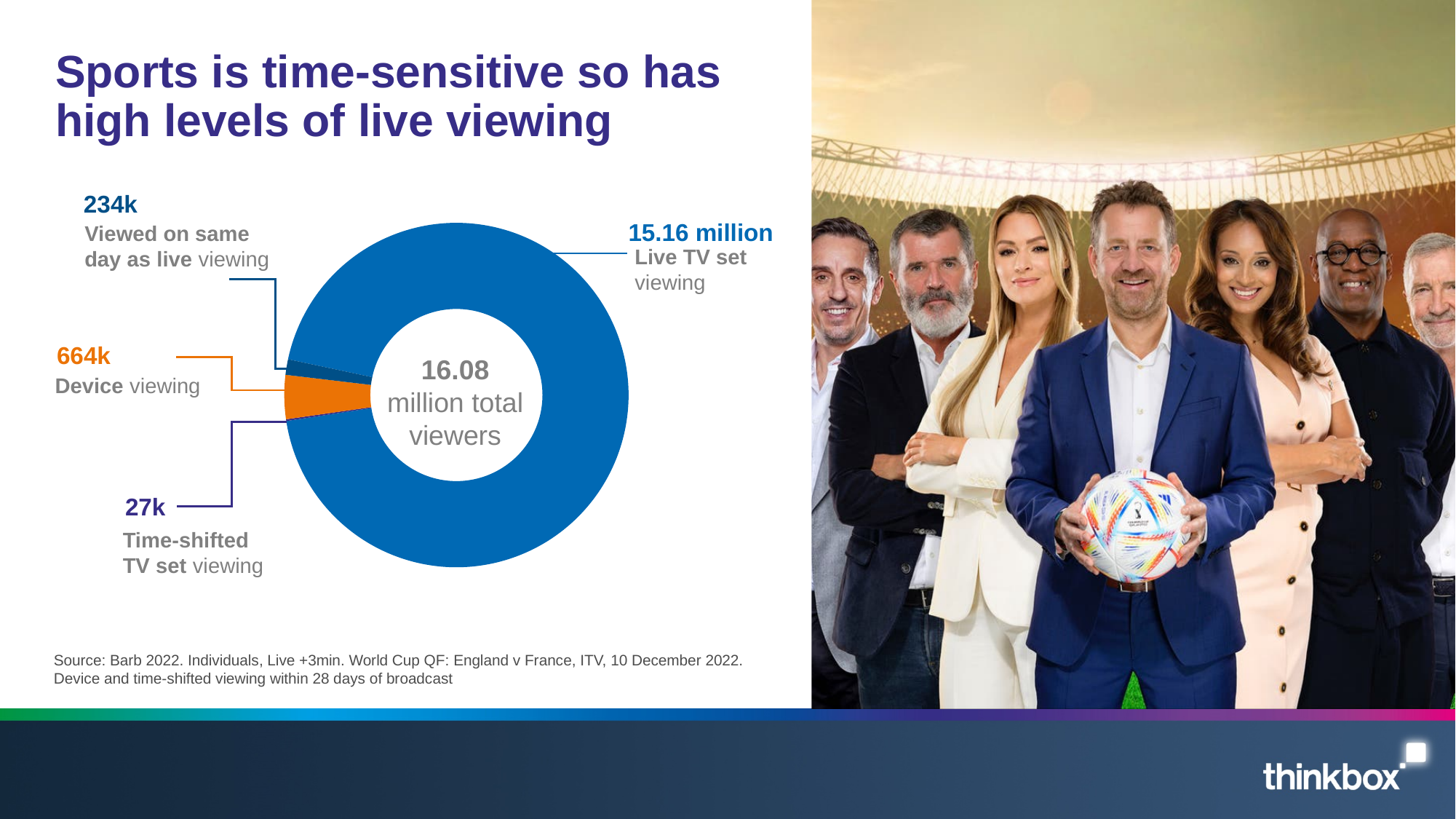
How many segments does the donut chart have? 4 What colour is the Device viewing segment? Orange What is the value for Time-shifted TV set viewing? 27k What is the value for Device viewing? 664k Which is larger, Device viewing or Viewed on same day as live viewing? Device viewing Which category has the smallest segment of the chart? Time-shifted TV set viewing What is the value for Viewed on same day as live viewing? 234k What kind of chart is shown on the slide? Donut (pie) chart What is the value for Live TV set viewing? 15.16 million Which category has the largest segment of the chart? Live TV set viewing What is the total number of viewers shown in the centre of the chart? 16.08 million total viewers What is the difference between Device viewing and Viewed on same day as live viewing? 430k